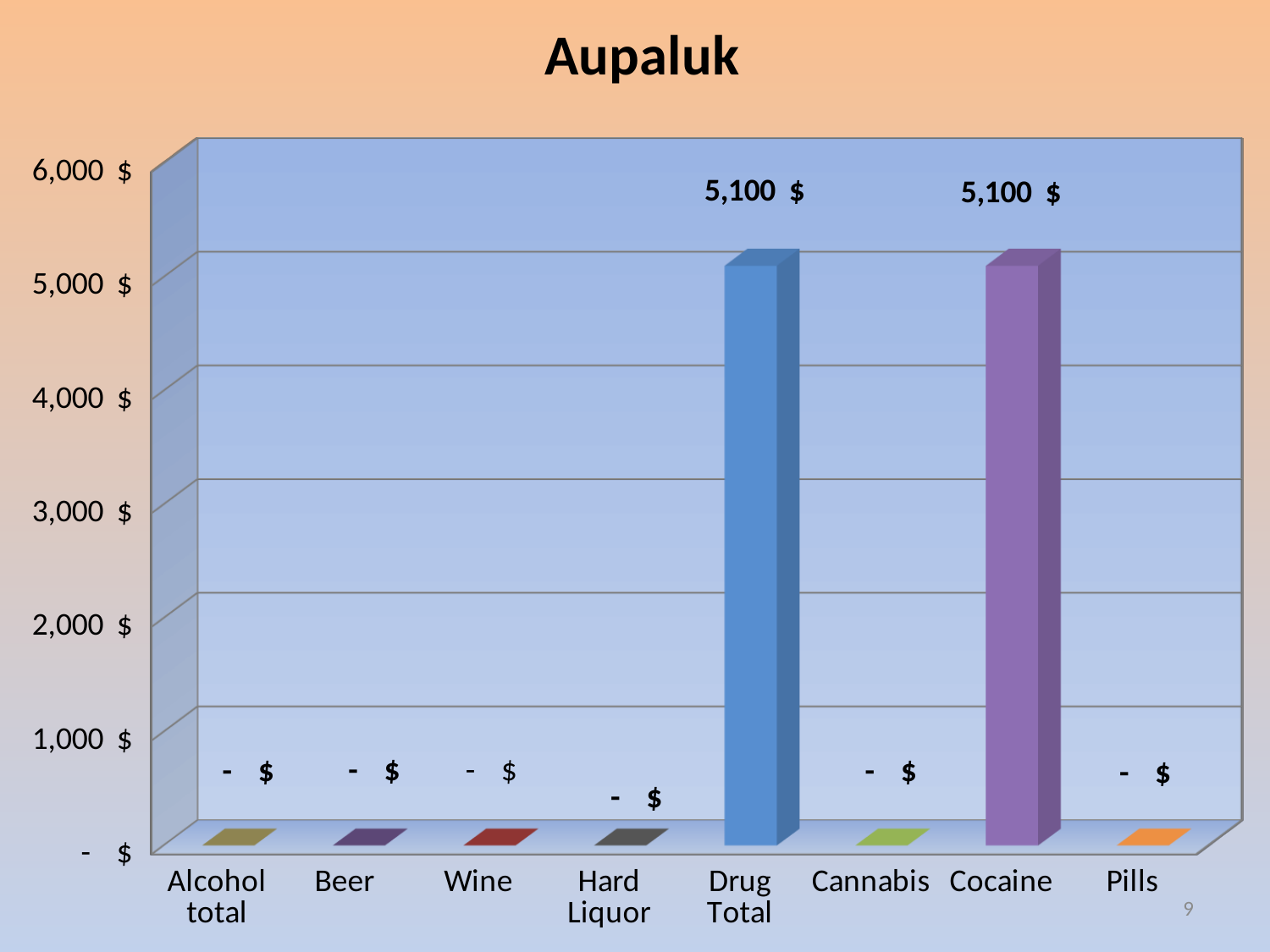
What is the title of the chart? Aupaluk Which is larger, the value for Drug Total or the value for Wine? Drug Total Which is larger, the value for Cocaine or the value for Beer? Cocaine What kind of chart is shown on the slide? bar chart What value is shown for Cannabis? - $ Which two categories have a non-zero value? Drug Total and Cocaine How many categories are shown on the x axis? 8 What is the value for Cocaine? 5,100 $ Is the value for Drug Total greater or less than 5,000 $? greater What value is shown for Beer? - $ What is the value for Drug Total? 5,100 $ Is the value for Cocaine greater or less than 6,000 $? less